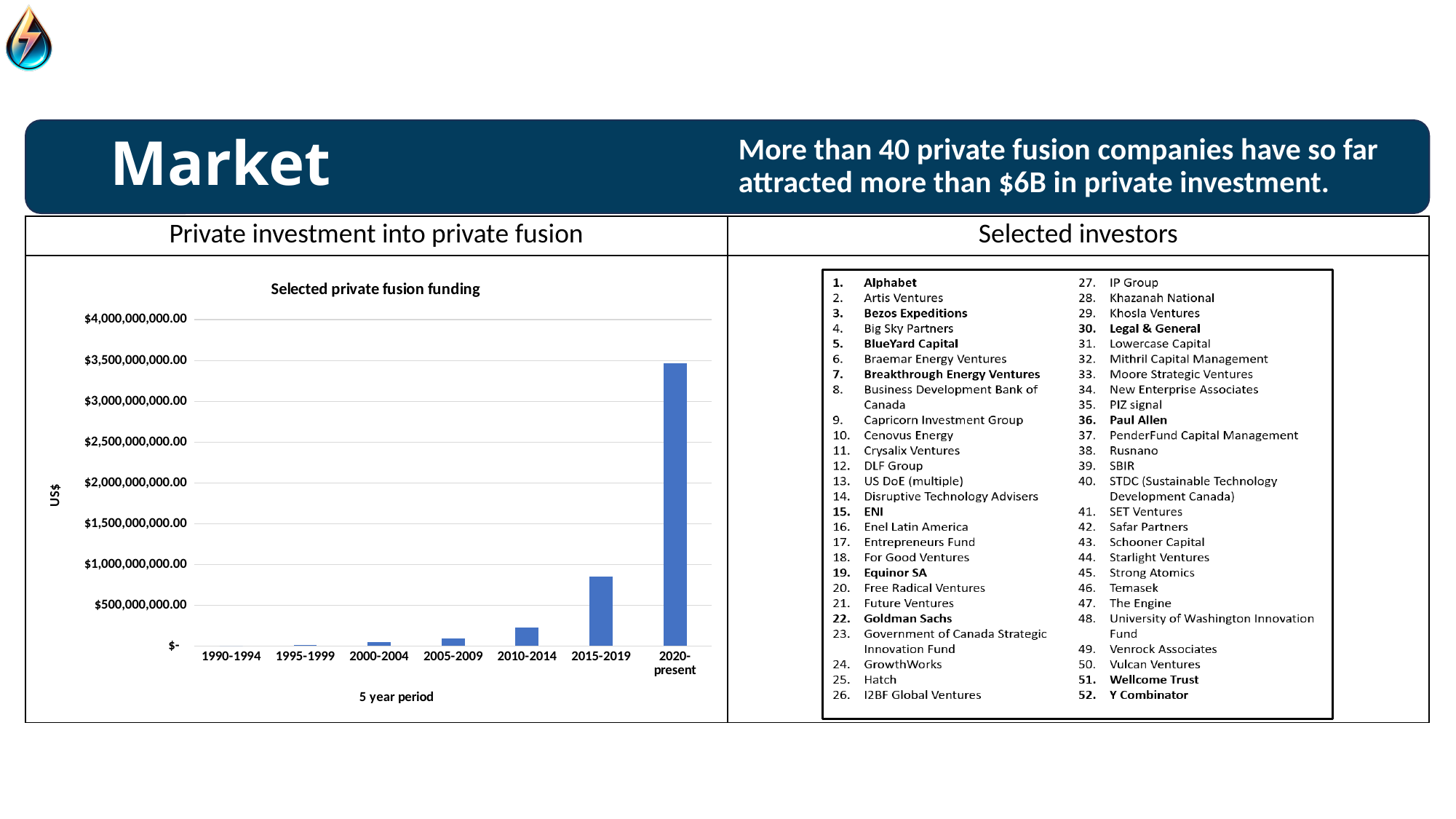
Is the funding for 2015-2019 greater or less than $1,000,000,000.00? less What kind of chart is shown under 'Private investment into private fusion'? bar chart What is the label on the y axis of the 'Selected private fusion funding' chart? US$ What is the title of the chart on the left side of the slide? Selected private fusion funding Is the funding for 2020-present greater or less than $3,000,000,000.00? greater Which period has higher funding, 2005-2009 or 2000-2004? 2005-2009 Is the funding for 2015-2019 greater or less than $500,000,000.00? greater Which period has the highest funding in the 'Selected private fusion funding' chart? 2020-present Do the funding values rise or fall from 1990-1994 to 2020-present? rise How many 5-year periods are shown on the x axis of the 'Selected private fusion funding' chart? 7 Which period has higher funding, 2010-2014 or 2015-2019? 2015-2019